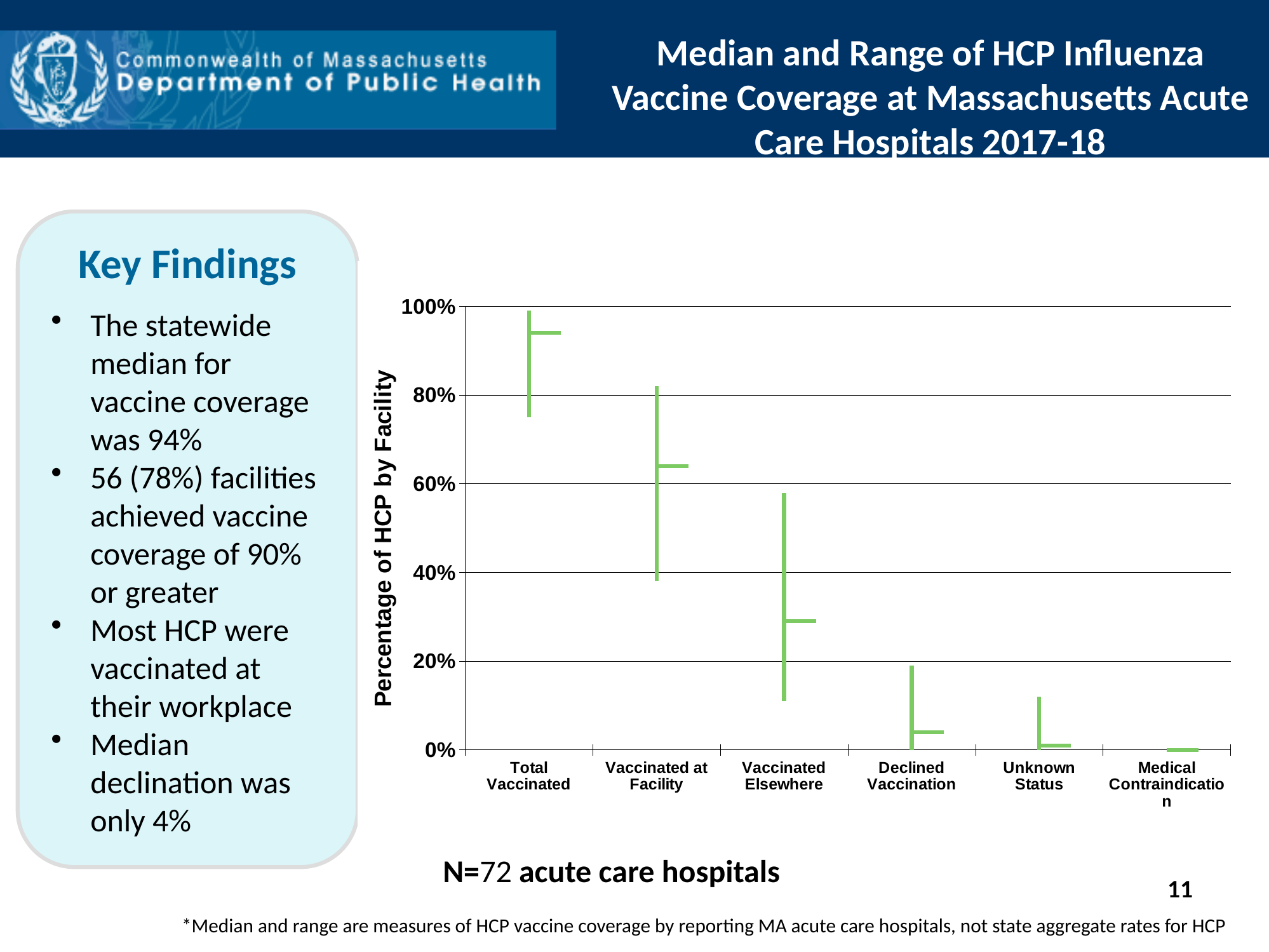
How many acute care hospitals does the chart's caption say are included (N)? 72 How many categories are shown on the x axis of the chart? 6 Is the median value for Vaccinated Elsewhere greater or less than 40%? less Is the median value for Total Vaccinated greater or less than 80%? greater Which category has the highest median value in the chart? Total Vaccinated Do the median values generally rise or fall moving from left to right along the x axis? fall Is the median value for Vaccinated at Facility greater or less than 60%? greater What is the label of the chart's y axis? Percentage of HCP by Facility Which has the larger median value, Vaccinated at Facility or Vaccinated Elsewhere? Vaccinated at Facility According to the slide, what was the statewide median for vaccine coverage (Total Vaccinated)? 94% Which category has the lowest top of its range in the chart? Medical Contraindication